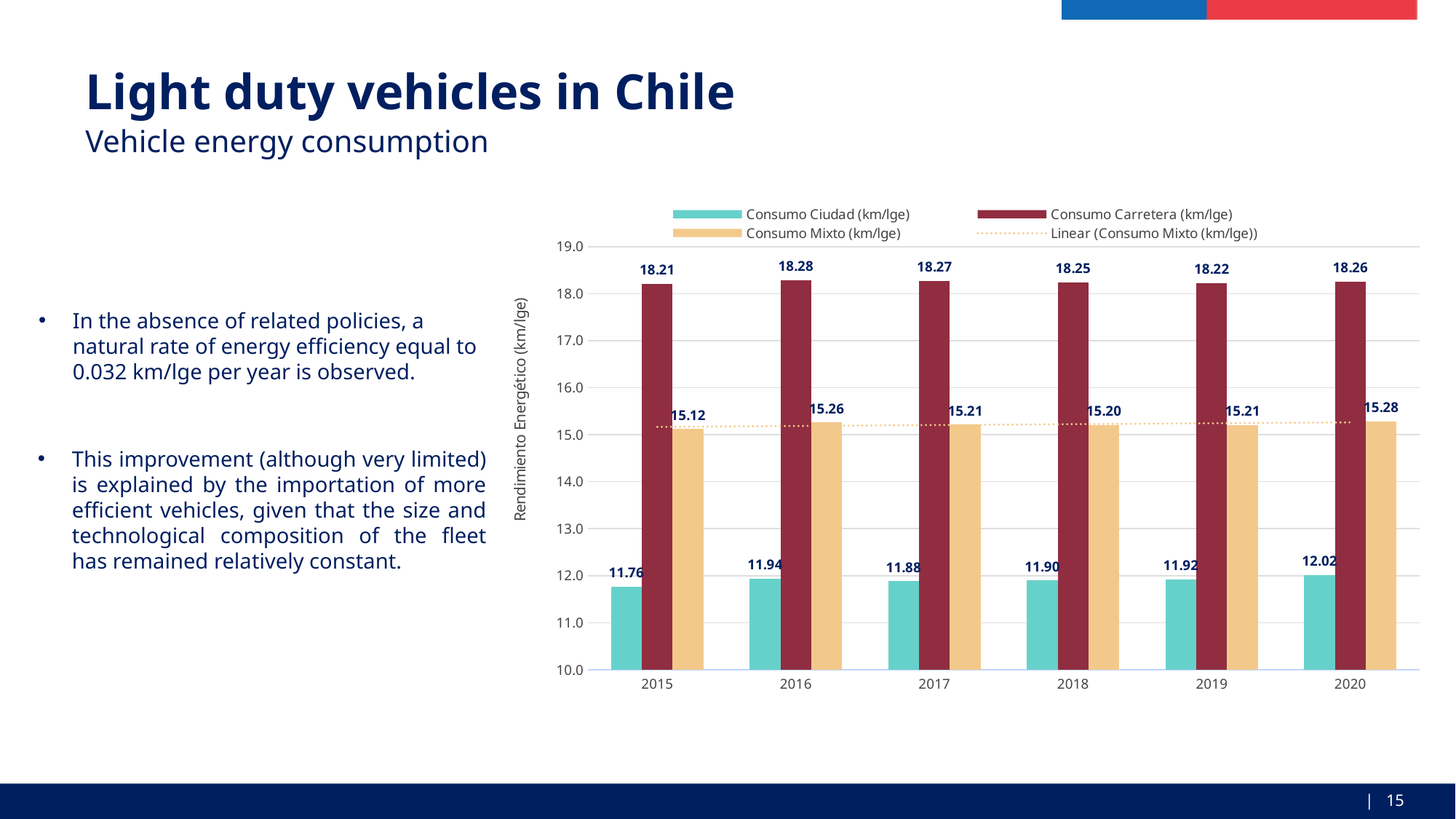
What is the y-axis label of the chart? Rendimiento Energético (km/lge) What is the Consumo Carretera (km/lge) value for 2018? 18.25 In which year is Consumo Ciudad (km/lge) lowest? 2015 Is the Consumo Mixto value for 2016 greater or less than 15.0? greater Which is larger in 2017: Consumo Mixto or Consumo Ciudad? Consumo Mixto What is the Consumo Ciudad (km/lge) value for 2015? 11.76 How many entries does the legend list? 4 What is the difference between Consumo Carretera and Consumo Ciudad in 2015? 6.45 In which year is Consumo Carretera (km/lge) highest? 2016 What is the Consumo Mixto (km/lge) value for 2020? 15.28 How many years are shown on the x axis? 6 What kind of chart is shown on the slide? bar chart